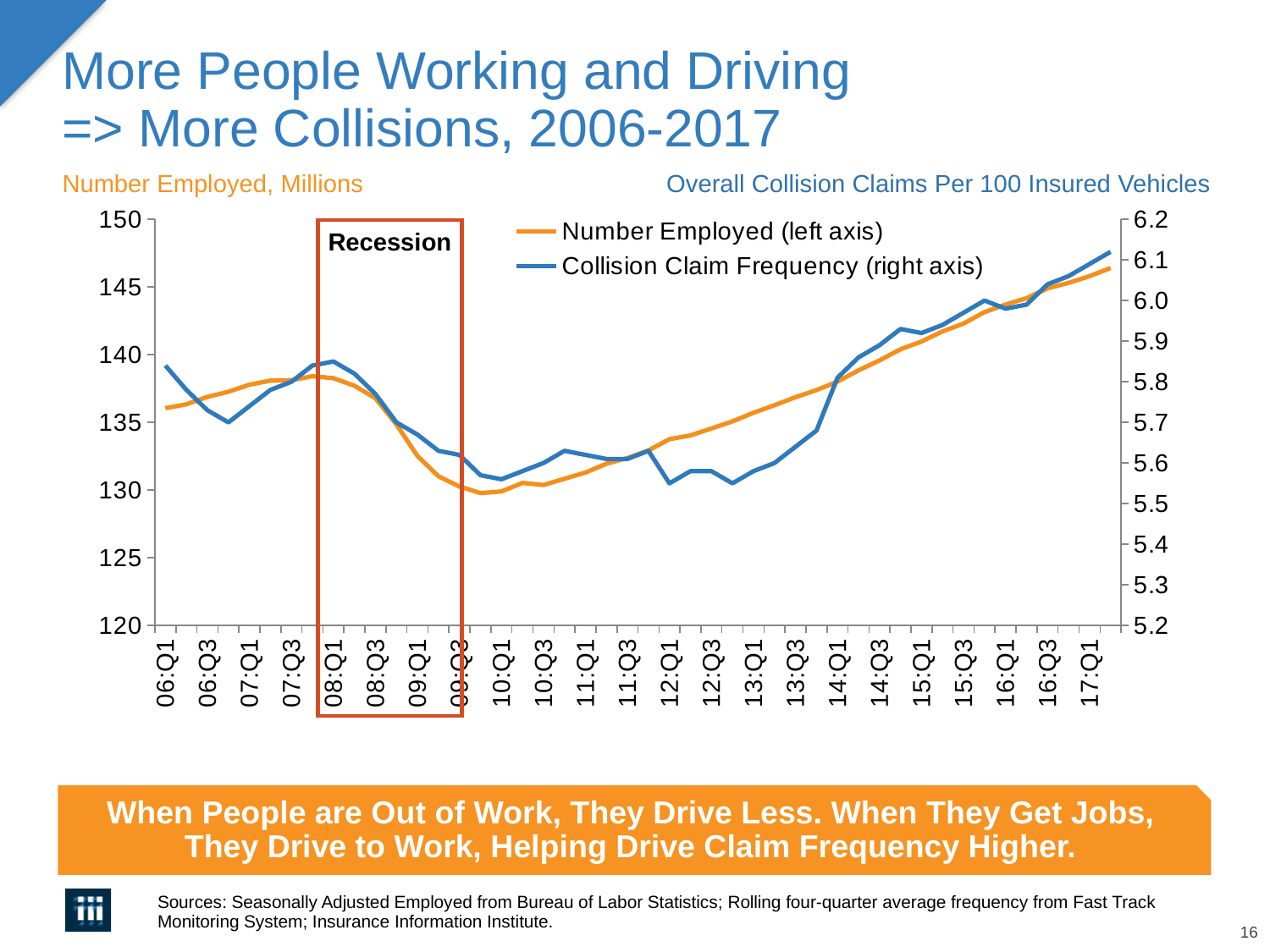
Is the value for Collision Claim Frequency at 17:Q1 greater or less than 6.0? greater Which is larger, Collision Claim Frequency at 06:Q1 or at 12:Q1? 06:Q1 Is the value for Collision Claim Frequency at 12:Q1 greater or less than 5.6? less Is the value for Number Employed at 17:Q1 greater or less than 145? greater What is the label of the left axis? Number Employed, Millions What kind of chart is shown on the slide? Line chart Does Number Employed rise or fall from 10:Q1 to 17:Q1? Rise Which series is plotted against the right axis according to the legend? Collision Claim Frequency How many series does the legend list? 2